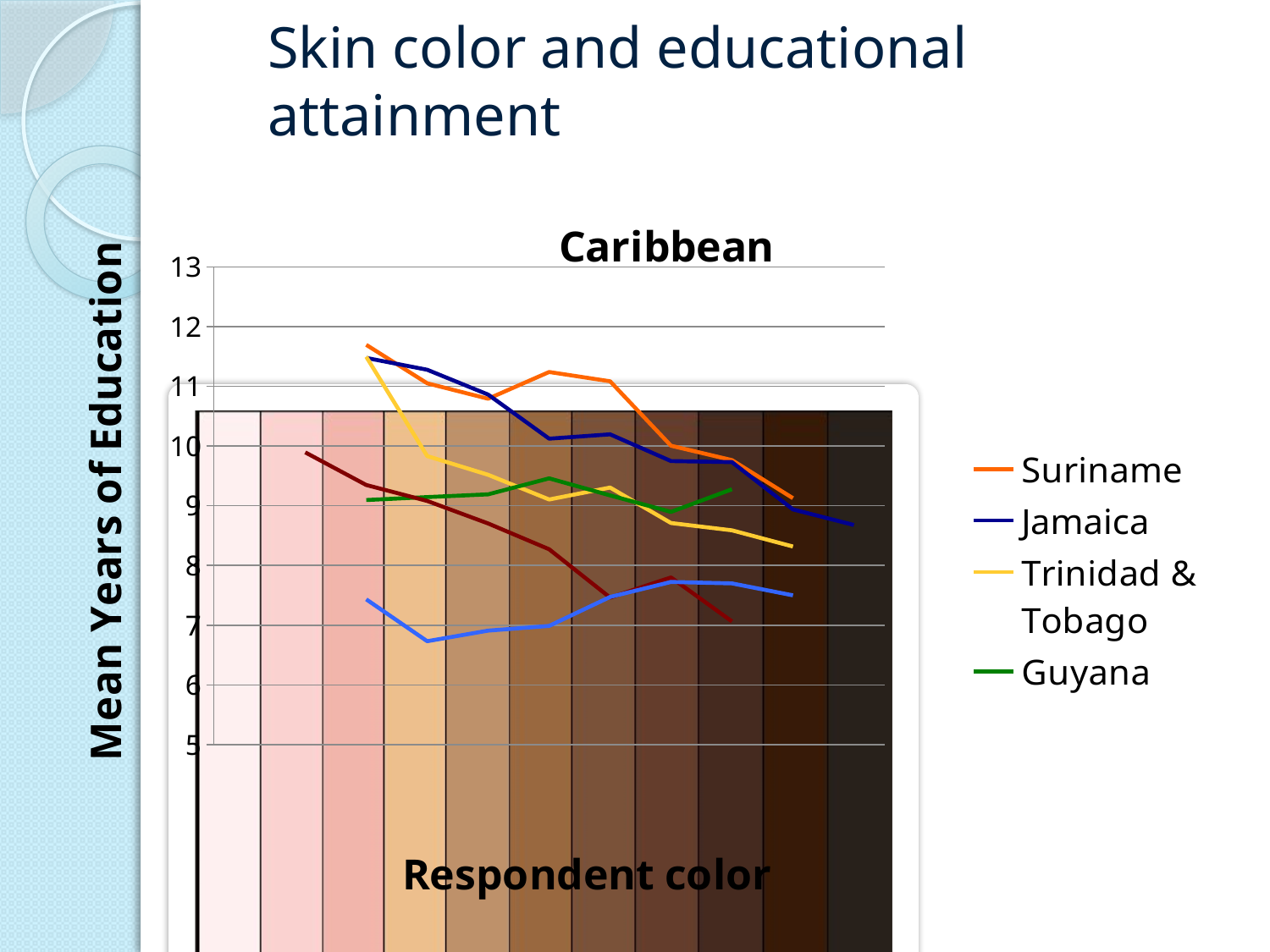
Does the Suriname line rise or fall overall from left to right? Fall Does the Jamaica line rise or fall overall from left to right? Fall Is the leftmost value of the Suriname line greater or less than 11? greater Is the rightmost value of the Trinidad & Tobago line greater or less than 9? less What kind of chart is shown on the slide? Line chart Is the highest point of the Guyana line greater or less than 10? less At the left end of the lines, which is higher: Suriname or Guyana? Suriname What is the title of the chart? Caribbean What is the label of the vertical axis of the chart? Mean Years of Education Does the Trinidad & Tobago line rise or fall overall from left to right? Fall How many series does the legend of the Caribbean chart list? 4